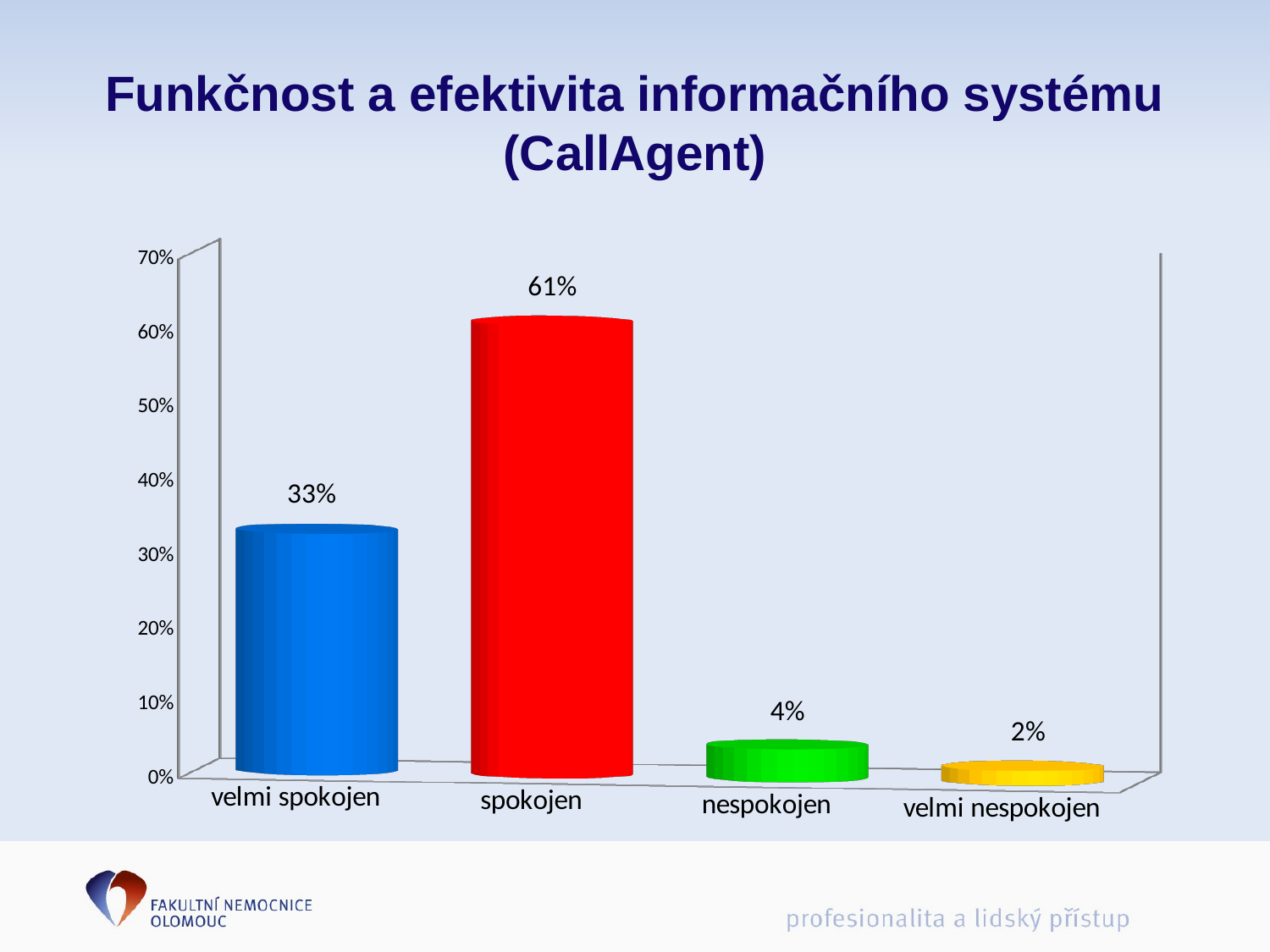
What is the value for "velmi nespokojen"? 2% What kind of chart is shown on the slide? bar chart What is the value for "spokojen"? 61% What colour is the bar for "spokojen"? red Is the value for "velmi spokojen" greater or less than 40%? less Which category has the lowest value? velmi nespokojen How many categories are shown on the x axis? 4 What is the difference between the values for "spokojen" and "velmi spokojen"? 28% Which is larger, the value for "velmi spokojen" or the value for "nespokojen"? velmi spokojen Which category has the highest value? spokojen What is the value for "nespokojen"? 4% What is the value for "velmi spokojen"? 33%